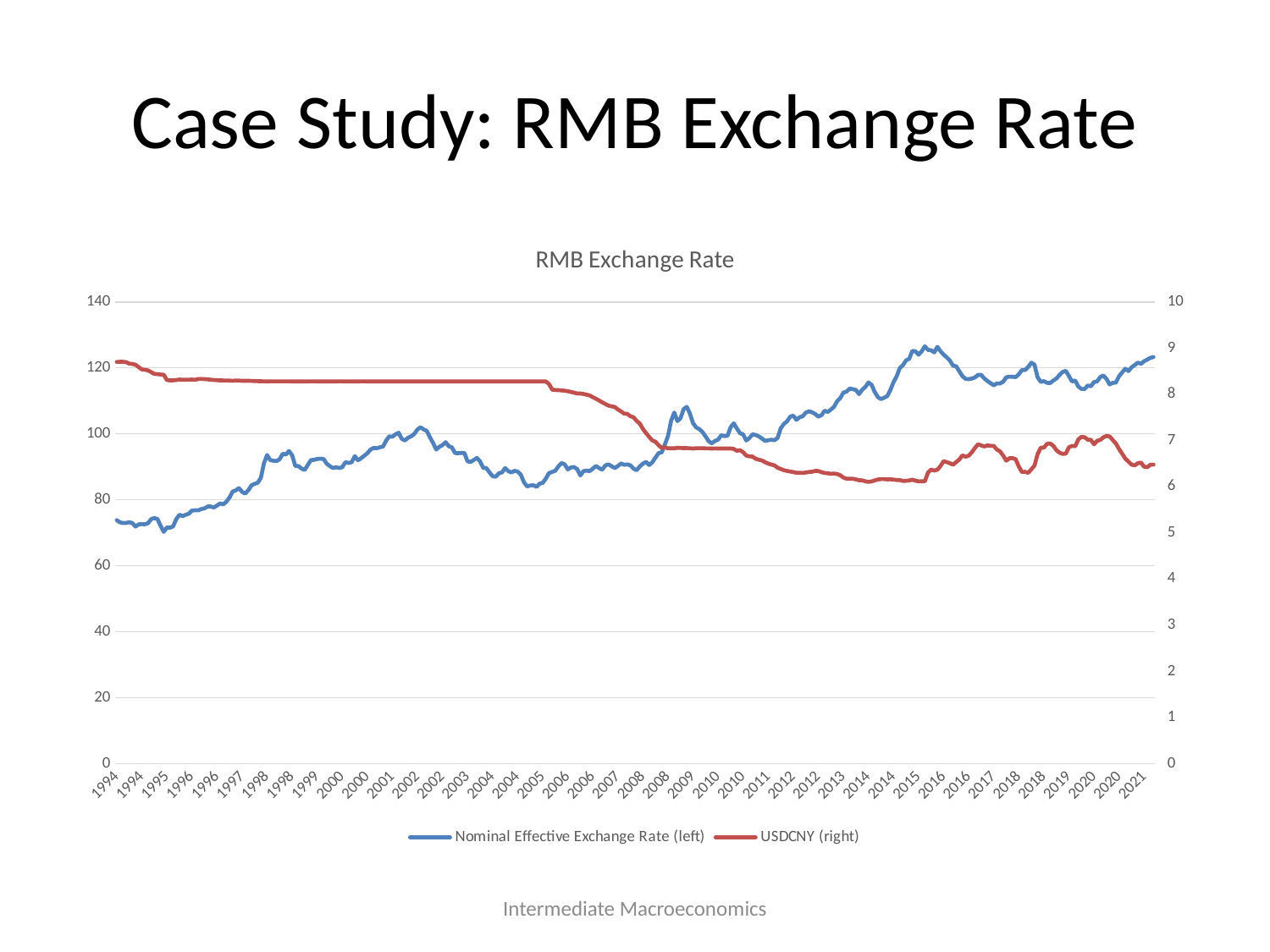
Is the value of USDCNY at the start of 1994 greater or less than 8? greater Is the value of USDCNY at the end of 2021 greater or less than 7? less Which series is plotted against the right axis according to the legend? USDCNY (right) Is the value of the Nominal Effective Exchange Rate at the start of 1994 greater or less than 80? less Does the Nominal Effective Exchange Rate overall rise or fall from 1994 to 2021? rise Does USDCNY rise or fall from 2005 to 2014? fall What kind of chart is shown on the slide? line chart How many series does the legend list? 2 What is the title of the chart? RMB Exchange Rate Which is larger for the Nominal Effective Exchange Rate: the value in 1994 or the value in 2015? 2015